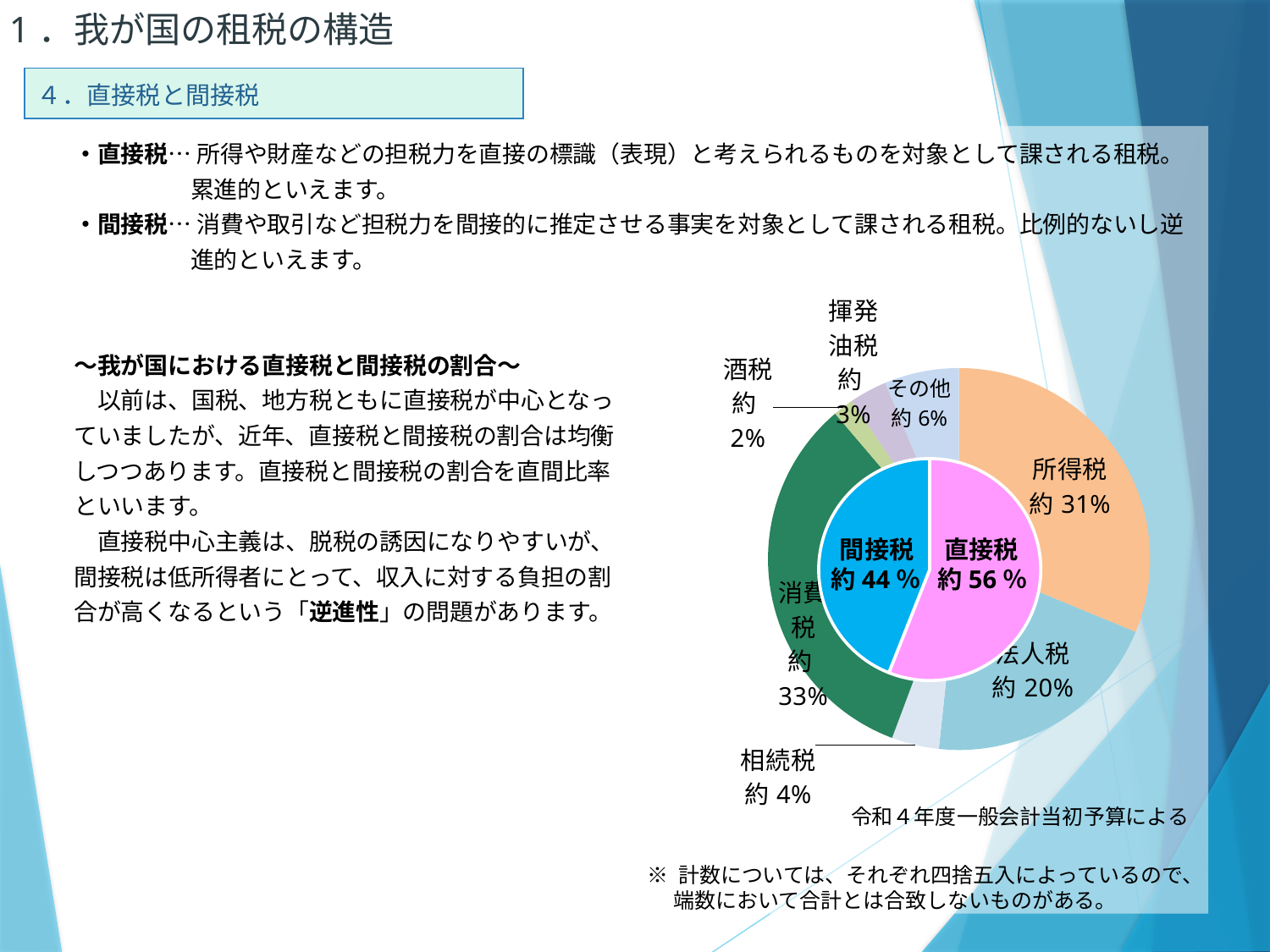
グラフで相続税の割合はいくらですか？ 約 4% グラフの外側の輪には税目がいくつ示されていますか？ 7 グラフの外側の輪で、最も割合が小さい税目はどれですか？ 酒税 グラフで、法人税と所得税ではどちらの割合が大きいですか？ 所得税 グラフの内側の輪で、間接税の割合はいくらですか？ 約 44％ グラフで所得税の割合はいくらですか？ 約 31% グラフのデータは何に基づいていますか？ 令和４年度一般会計当初予算 このスライドのグラフはどの種類のグラフですか？ 円グラフ グラフで消費税の割合はいくらですか？ 約 33% グラフの内側の輪で、直接税の割合はいくらですか？ 約 56％ グラフで、直接税と間接税の割合の差は何ポイントですか？ 12ポイント グラフの外側の輪で、最も割合が大きい税目はどれですか？ 消費税